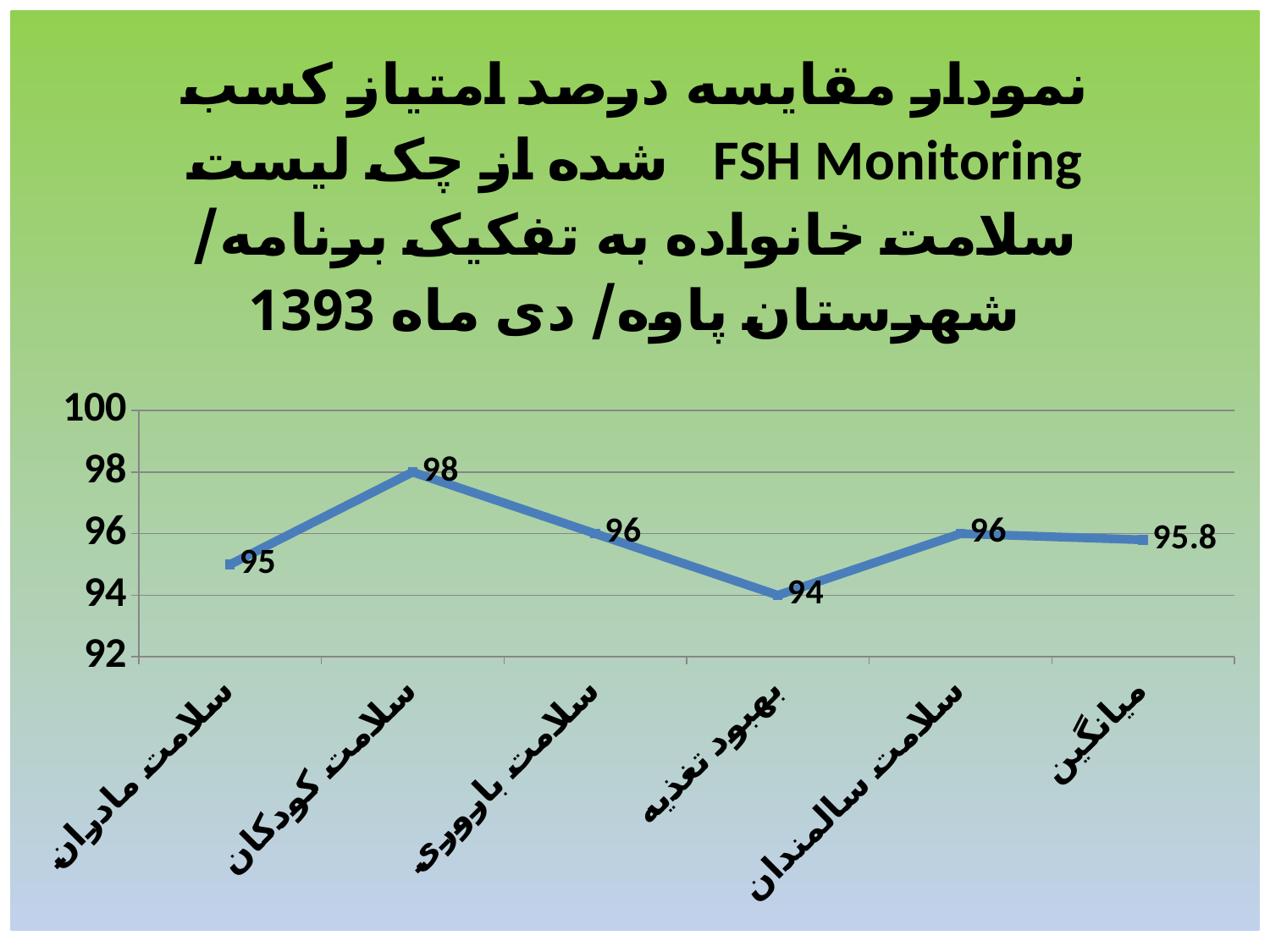
What is the difference between the values for سلامت سالمندان and میانگین? 0.2 What is the difference between the values for سلامت کودکان and بهبود تغذیه? 4 Which category has the lowest value? بهبود تغذیه Which is larger, the value for سلامت باروری or the value for سلامت مادران? سلامت باروری Does the line rise or fall from سلامت کودکان to بهبود تغذیه? fall Which category has the highest value? سلامت کودکان What is the value for بهبود تغذیه? 94 What is the value for میانگین? 95.8 How many categories are plotted on the x axis? 6 What is the value for سلامت کودکان? 98 What type of chart is shown on the slide? line chart What is the value for سلامت مادران? 95